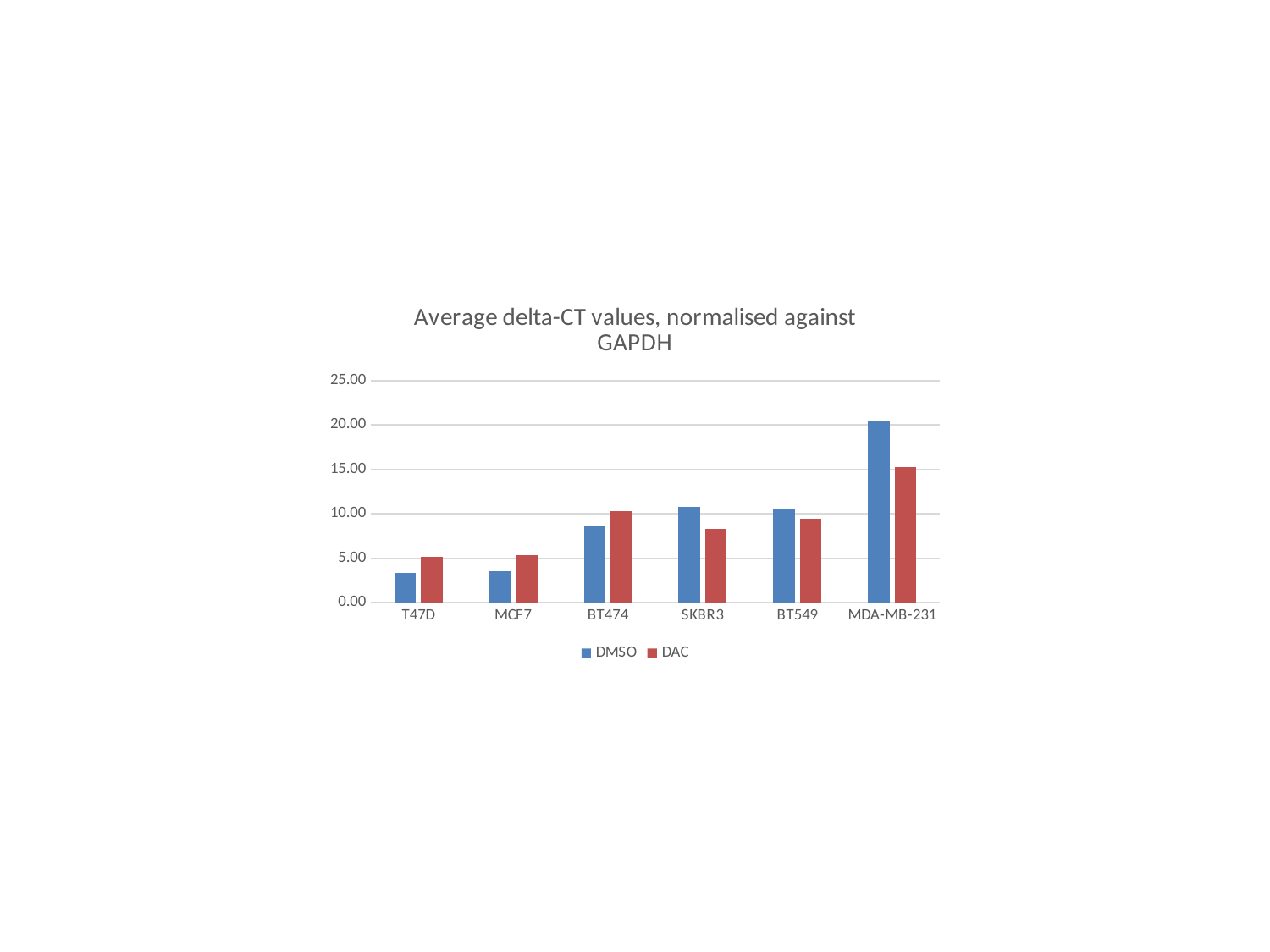
Which cell line has the highest DMSO value? MDA-MB-231 Is the DMSO value for MDA-MB-231 greater or less than 15.00? greater Is the DAC value for MDA-MB-231 greater or less than 20.00? less Is the DAC value for SKBR3 greater or less than 10.00? less What is the title of the chart? Average delta-CT values, normalised against GAPDH For SKBR3, which is larger, the DMSO value or the DAC value? DMSO How many cell lines are shown on the x axis? 6 What type of chart is shown on the slide? bar chart How many series does the legend list? 2 For T47D, which is larger, the DMSO value or the DAC value? DAC Which cell line has the highest DAC value? MDA-MB-231